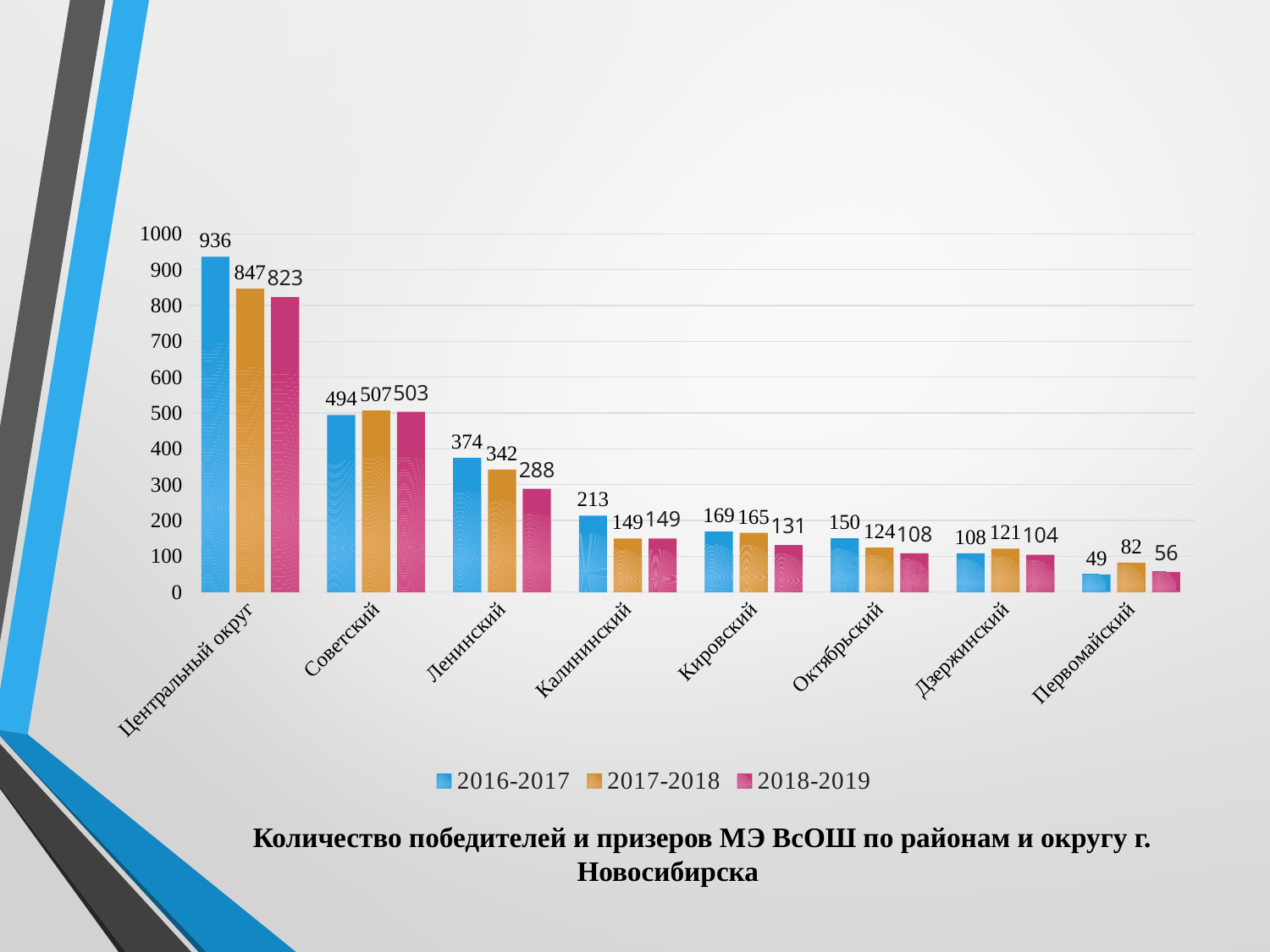
How many districts are shown on the x axis? 8 Which district has the highest value in 2017-2018? Центральный округ What is the value for Первомайский in 2017-2018? 82 What is the value for Ленинский in 2018-2019? 288 Which colour represents the 2018-2019 series in the legend? Pink What is the difference between the 2016-2017 and 2018-2019 values for Калининский? 64 Do the 2016-2017 values rise or fall from Центральный округ to Первомайский? Fall What is the value for Центральный округ in 2016-2017? 936 Which is larger for Советский: the 2017-2018 value or the 2018-2019 value? 2017-2018 What kind of chart is shown on the slide? Bar chart How many series does the legend list? 3 Which district has the lowest value in 2016-2017? Первомайский